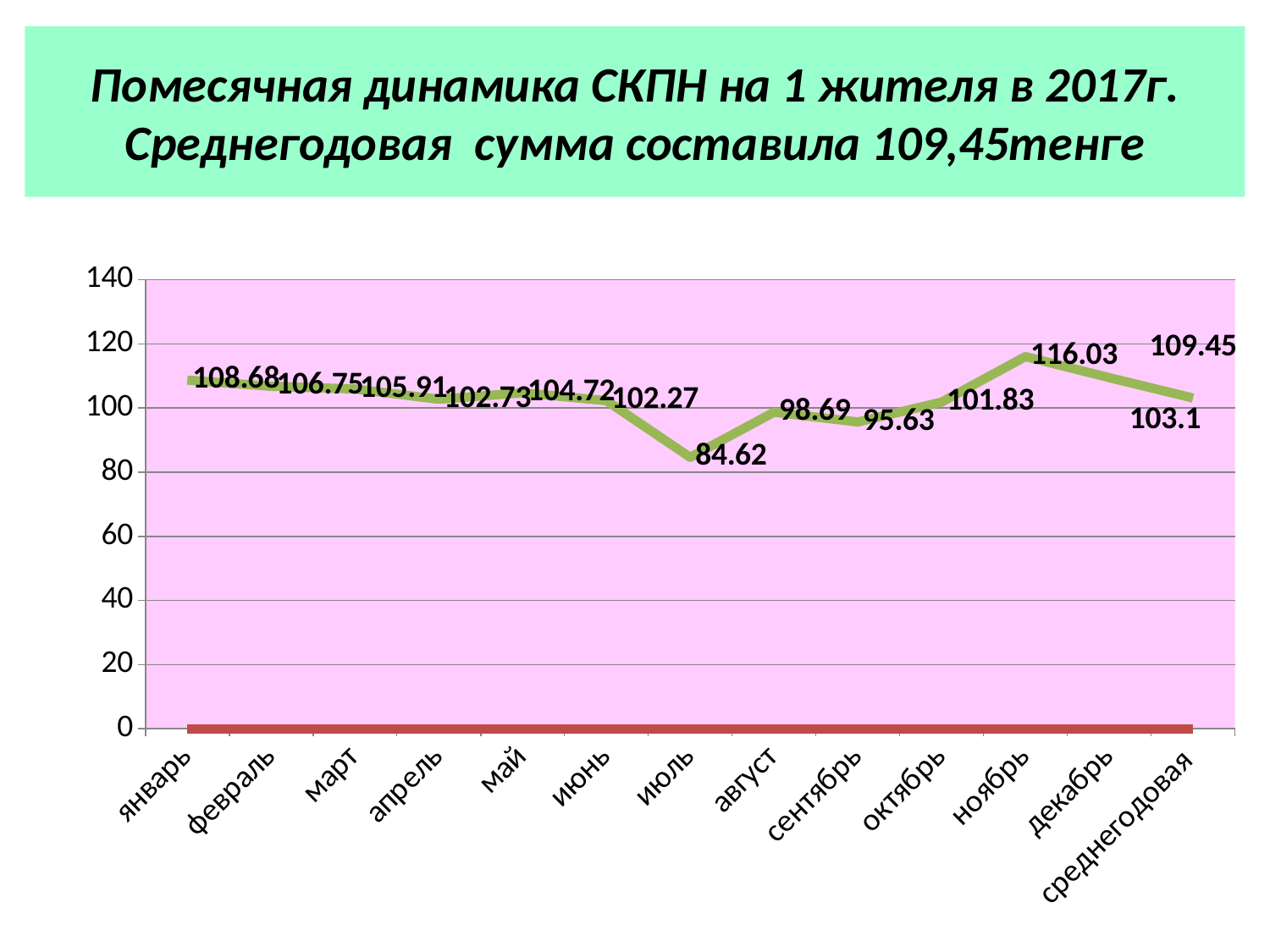
What is the value for ноябрь? 116.03 Is the value for август greater or less than 100? less How many categories are shown on the x axis? 13 Which category has the lowest value? июль Which is larger, the value for март or the value for апрель? март What is the value for июль? 84.62 What is the value for сентябрь? 95.63 What is the difference between the values for ноябрь and июль? 31.41 What kind of chart is shown on the slide? line chart Which category has the highest value? ноябрь What is the value for январь? 108.68 Do the values rise or fall from январь to апрель? fall